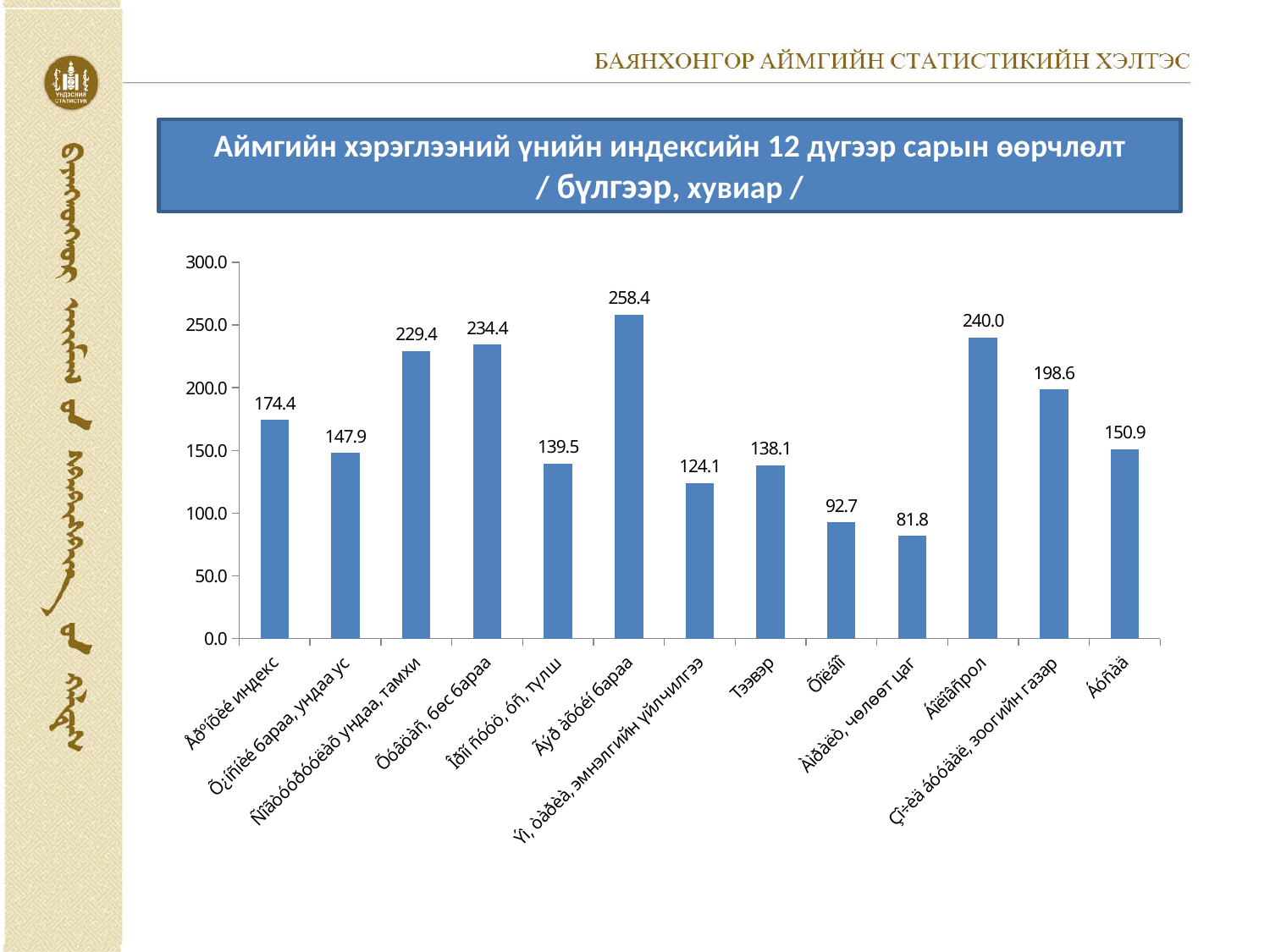
Is the value for Тээвэр greater or less than 150? less What type of chart is shown on the slide? bar chart What is the value shown for Тээвэр? 138.1 What is the value of the rightmost bar in the chart? 150.9 What is the difference between the highest and lowest values in the chart? 176.6 How many bars (categories) are plotted in the chart? 13 What is the difference between the value of the leftmost bar and the value for Тээвэр? 36.3 What is the lowest value shown in the chart? 81.8 What is the highest value shown in the chart? 258.4 What is the value of the leftmost bar in the chart? 174.4 What is the maximum value shown on the vertical axis of the chart? 300.0 Which is larger: the value for Тээвэр or the value of the leftmost bar? the leftmost bar